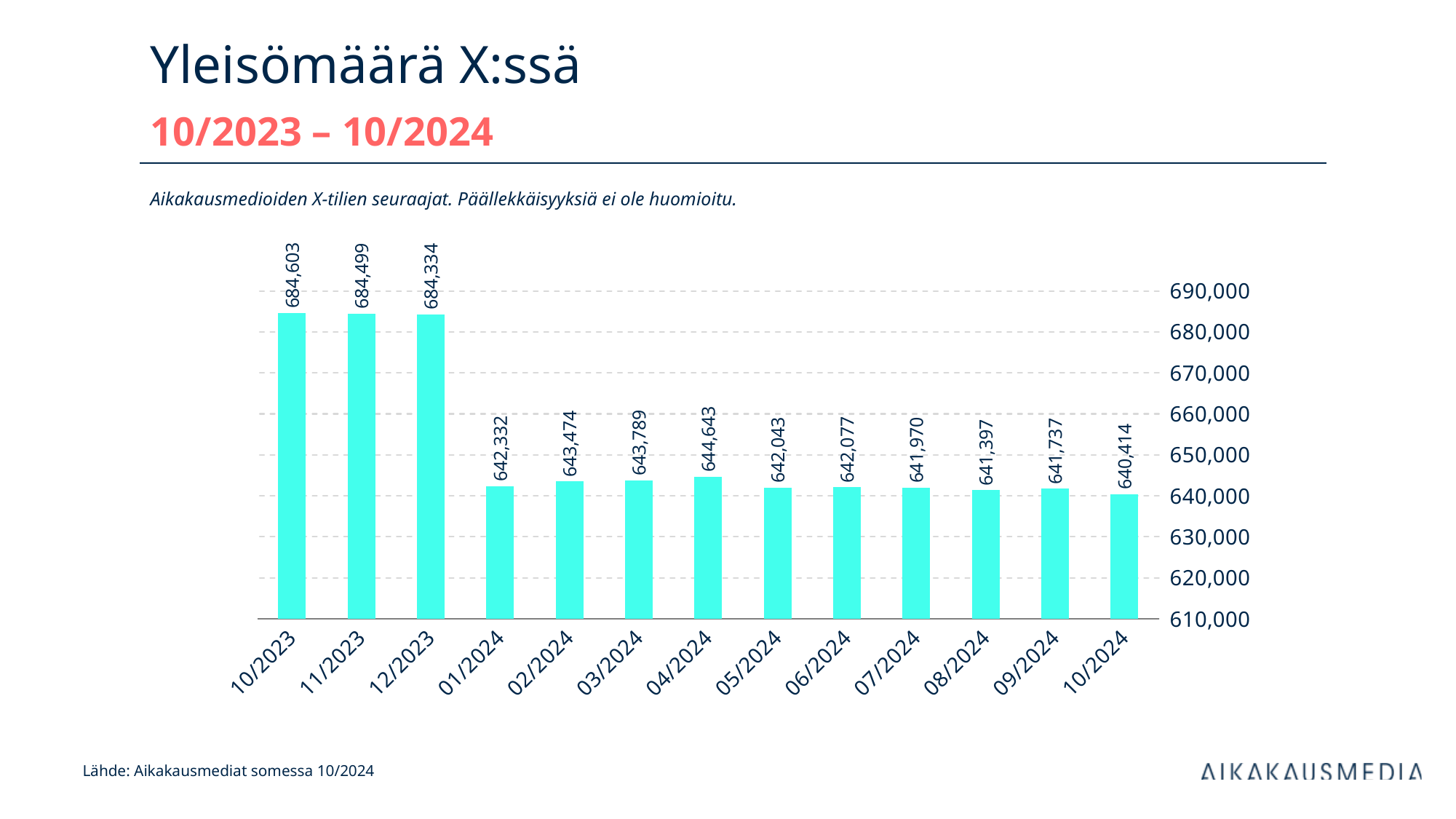
What is the difference between the values for 10/2023 and 10/2024? 44,189 Which is larger, the value for 03/2024 or the value for 04/2024? 04/2024 What kind of chart is shown on the slide? bar chart Is the value for 01/2024 greater or less than 650,000? less What is the difference between the values for 12/2023 and 01/2024? 42,002 Which month has the lowest value? 10/2024 How many months are shown on the x axis? 13 Do the values generally rise or fall from 10/2023 to 10/2024? fall Which month has the highest value? 10/2023 What is the value for 10/2023? 684,603 What is the value for 04/2024? 644,643 What is the value for 10/2024? 640,414